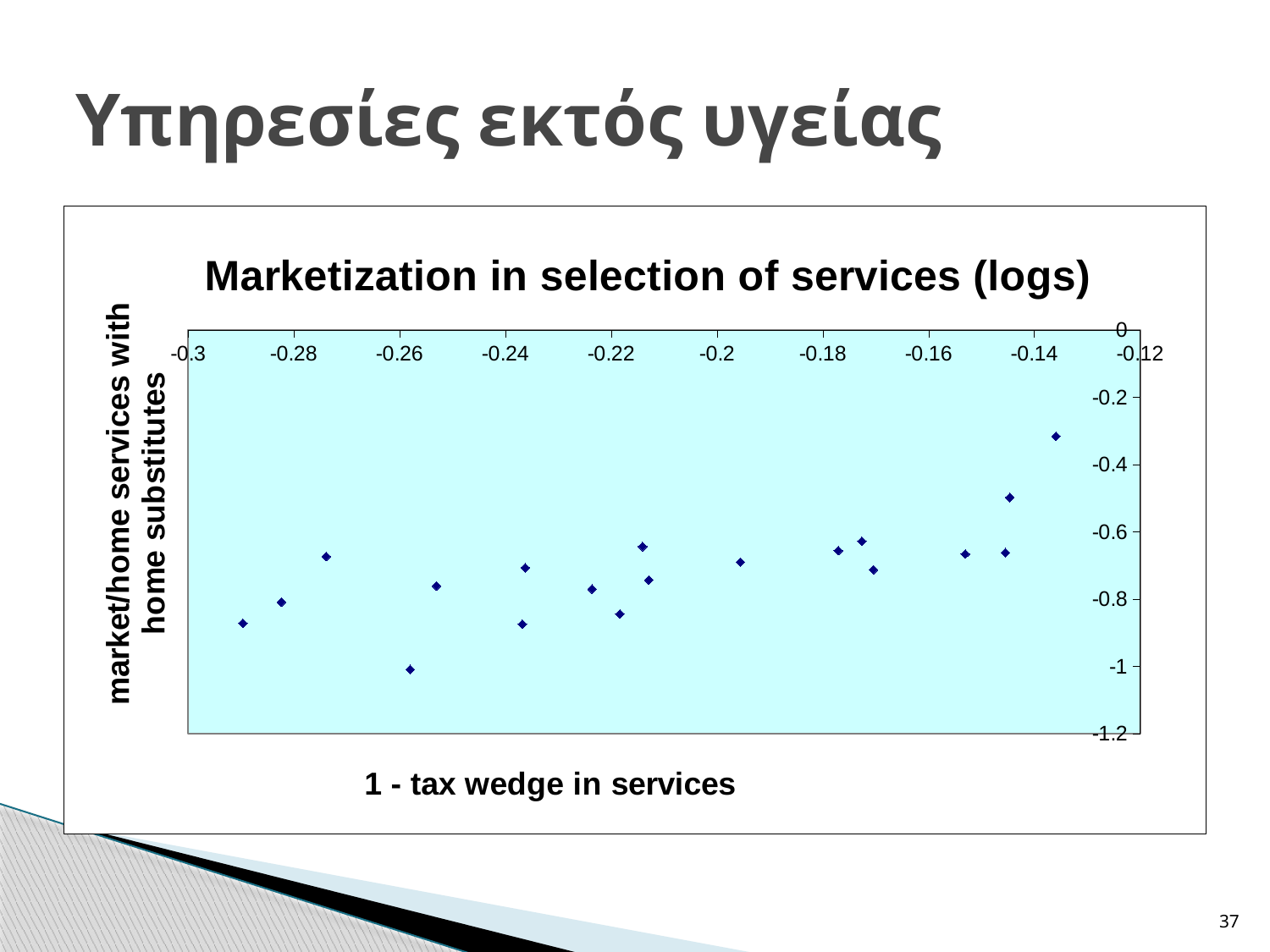
What is the lowest tick value shown on the vertical axis? -1.2 Is the highest point located near the right end or the left end of the horizontal axis? right end What kind of chart is shown on the slide? scatter chart Do the plotted values generally rise or fall as the horizontal axis value increases from -0.3 toward -0.12? rise Is the point plotted near x = -0.14 at about -0.5 higher or lower than the point near x = -0.15? higher How many data points are plotted on the chart? 19 What is the label of the horizontal axis? 1 - tax wedge in services Is the highest plotted point greater or less than -0.4 on the vertical axis? greater Is the point plotted near x = -0.26 greater or less than -0.8 on the vertical axis? less What is the title of the chart? Marketization in selection of services (logs)